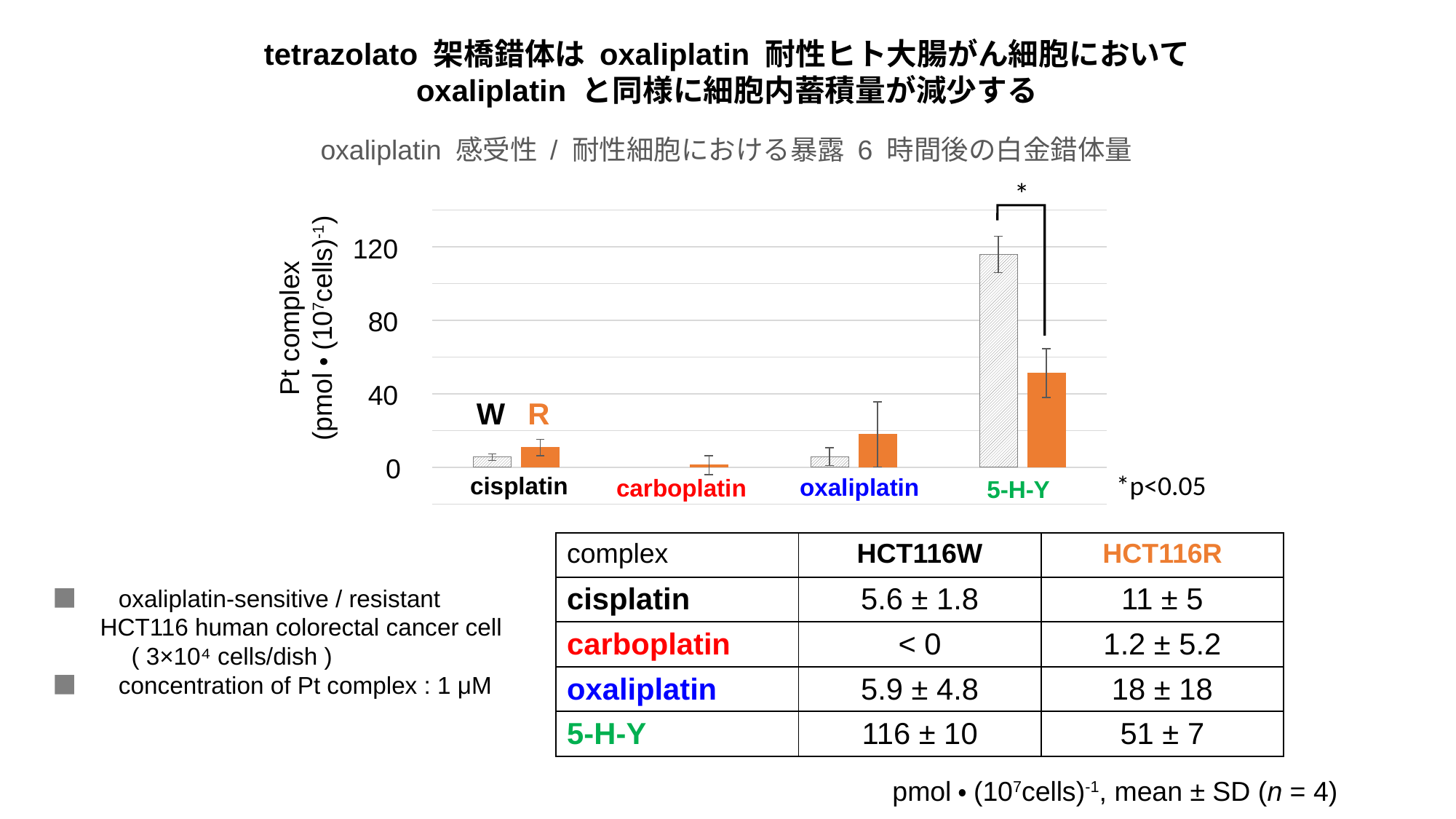
Which complex has the highest bar for the W (HCT116W) series? 5-H-Y Is the R bar for 5-H-Y greater or less than 80? less How many series does the chart show (labelled W and R)? 2 According to the table, what is the mean Pt complex value for 5-H-Y in HCT116W? 116 ± 10 How many Pt complexes (categories) are plotted on the x axis of the chart? 4 Is the W bar for 5-H-Y greater or less than 80? greater What is the difference between the mean 5-H-Y values for HCT116W and HCT116R in the table? 65 Which complex has the highest bar for the R (HCT116R) series? 5-H-Y What type of chart is shown on the slide? bar chart For 5-H-Y, which is larger: the W bar or the R bar? W According to the table, what is the value for oxaliplatin in HCT116R? 18 ± 18 According to the table, what is the mean Pt complex value for 5-H-Y in HCT116R? 51 ± 7